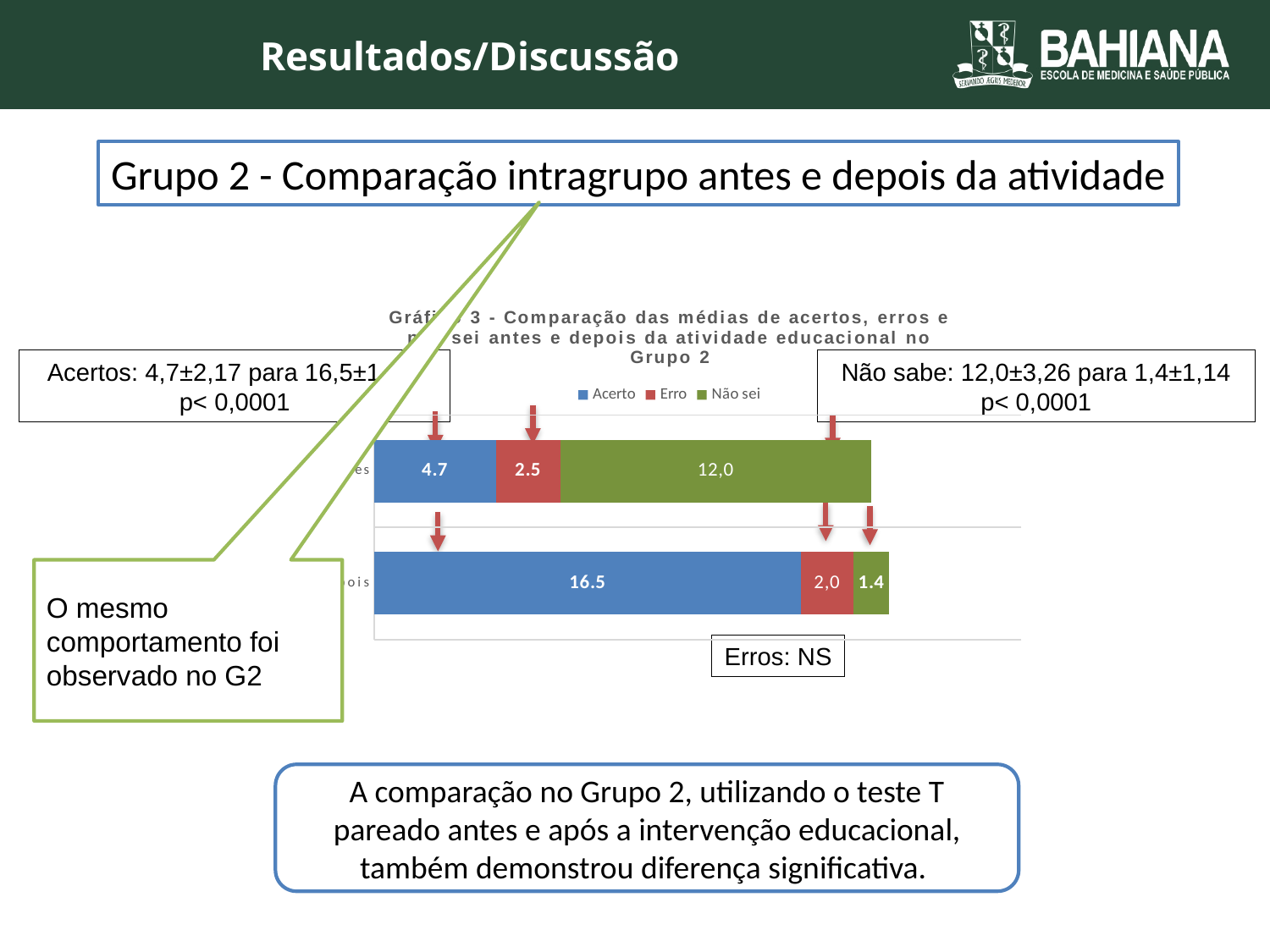
What is the Não sei value in the top bar (Antes)? 12,0 Which series has the smallest value in the bottom bar (Depois)? Não sei What is the Erro value in the bottom bar (Depois)? 2,0 What is the Acerto value in the top bar (Antes)? 4.7 What is the Acerto value in the bottom bar (Depois)? 16.5 How many series does the chart legend list? 3 What is the Não sei value in the bottom bar (Depois)? 1.4 What kind of chart is shown on the slide? Stacked bar chart Which colour represents the Erro series in the chart? Red By how much does the Acerto value increase from the top bar (Antes) to the bottom bar (Depois)? 11.8 How many bars (categories) are plotted in the chart? 2 Which series has the largest value in the top bar (Antes)? Não sei